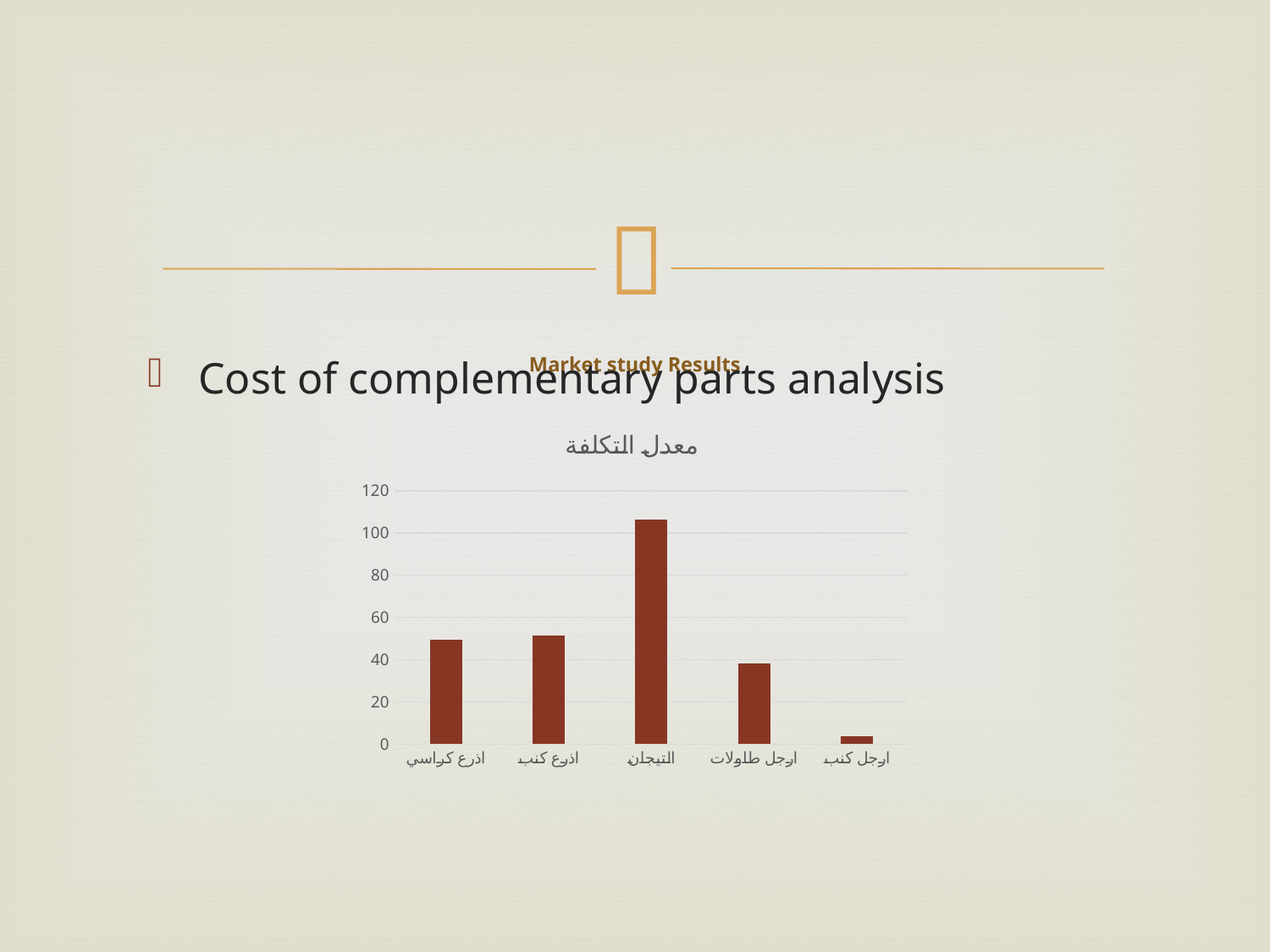
How many categories are plotted in the chart? 5 Is the value for ارجل كنب greater or less than 20? less Which category has the lowest value in the chart? ارجل كنب Which category has the highest value in the chart? التيجان Which is larger, the value for اذرع كراسي or the value for ارجل كنب? اذرع كراسي What is the title of the chart? معدل التكلفة Which is larger, the value for التيجان or the value for ارجل طاولات? التيجان What is the highest value shown on the vertical axis of the chart? 120 Is the value for اذرع كنب greater or less than 60? less What kind of chart is shown on the slide? bar chart Is the value for التيجان greater or less than 100? greater